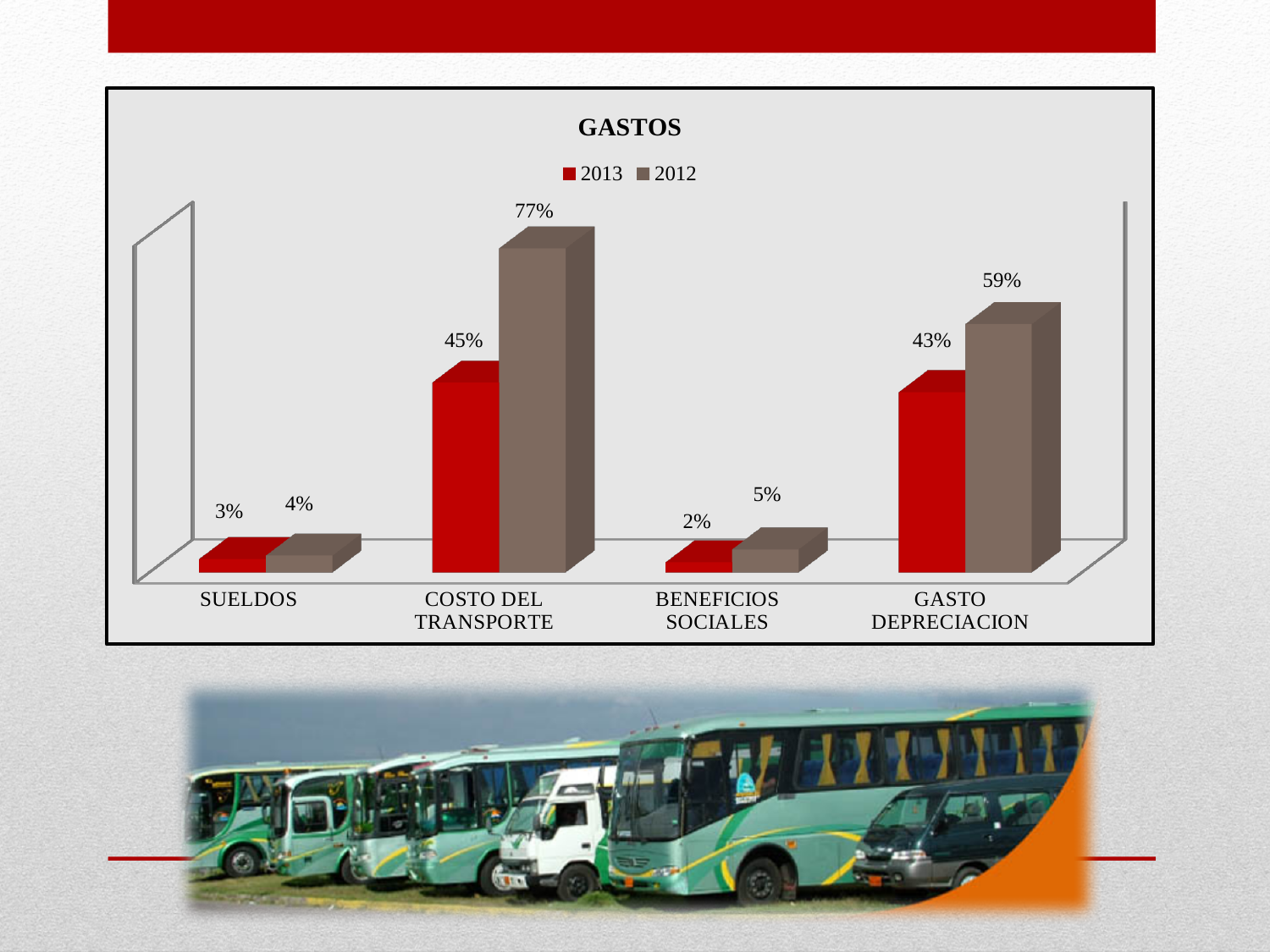
What kind of chart is shown? Bar chart Which is larger, the 2013 value for GASTO DEPRECIACION or the 2013 value for COSTO DEL TRANSPORTE? COSTO DEL TRANSPORTE What is the difference between the 2012 and 2013 values for GASTO DEPRECIACION? 16% How many categories are shown on the x axis? 4 What is the value for BENEFICIOS SOCIALES in 2012? 5% Which category has the highest value for 2012? COSTO DEL TRANSPORTE What is the value for GASTO DEPRECIACION in 2012? 59% What is the value for SUELDOS in 2013? 3% What is the difference between the 2012 and 2013 values for COSTO DEL TRANSPORTE? 32% How many series does the legend list? 2 What is the value for COSTO DEL TRANSPORTE in 2013? 45% Which category has the lowest value for 2013? BENEFICIOS SOCIALES